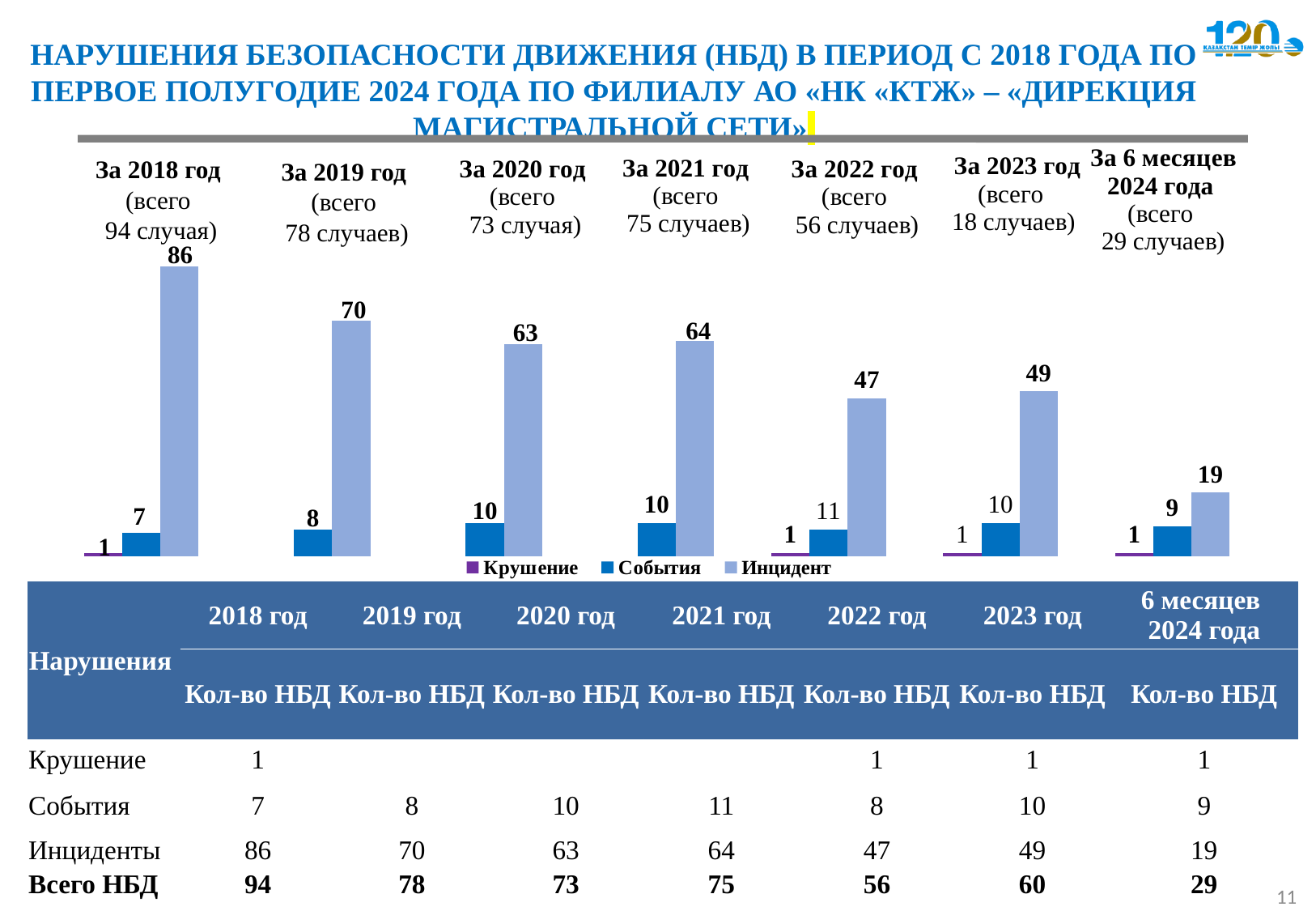
What are the three series names listed in the chart legend? Крушение, События, Инцидент Which is larger, the Инцидент value for За 2020 год or for За 2021 год? За 2021 год Which period has the highest Инцидент value? За 2018 год Which period has the lowest Инцидент value? За 6 месяцев 2024 года Does the Инцидент value rise or fall from За 2018 год to За 2020 год? fall What is the value of the Инцидент series for За 2023 год? 49 How many periods (category groups) are shown on the x axis of the chart? 7 What is the value of the События series for За 2019 год? 8 How many series does the legend list? 3 What kind of chart is shown on the slide? bar chart What is the difference between the Инцидент values for За 2018 год and За 2019 год? 16 What is the value of the Инцидент series for За 2018 год? 86